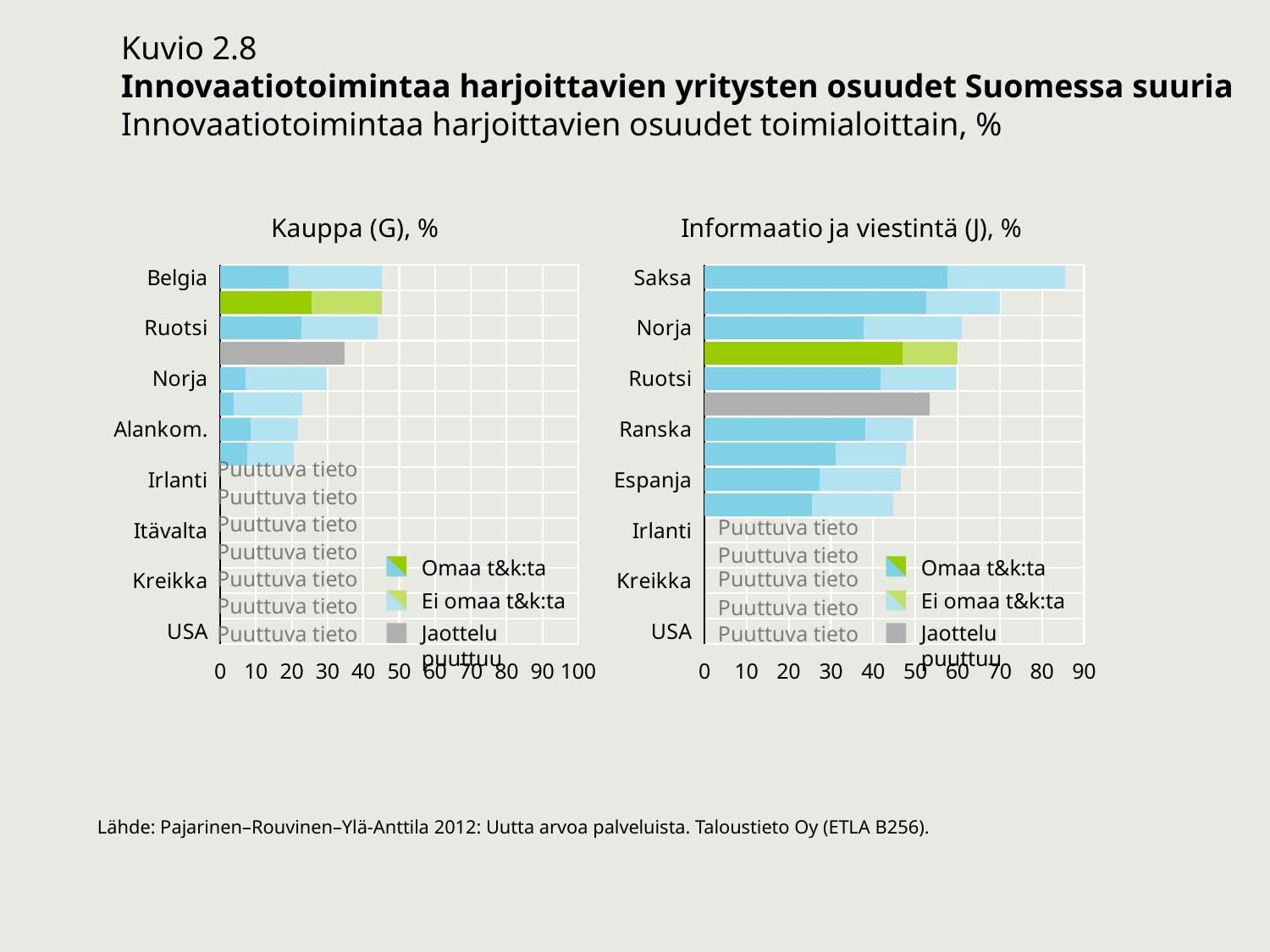
In the "Kauppa (G), %" chart, is the total value for Norja greater or less than 40? less In the "Informaatio ja viestintä (J), %" chart, is the total value for Norja greater or less than 50? greater In the "Informaatio ja viestintä (J), %" chart, is the total value for Saksa greater or less than 80? greater In the "Informaatio ja viestintä (J), %" chart, which labelled country has the highest total value? Saksa In the "Kauppa (G), %" chart, which has the larger total value, Belgia or Norja? Belgia What kind of chart is the "Kauppa (G), %" chart? bar chart How many series does the legend of the "Informaatio ja viestintä (J), %" chart list? 3 In the "Informaatio ja viestintä (J), %" chart, which has the larger total value, Saksa or Ranska? Saksa In the "Kauppa (G), %" chart, which labelled countries are marked "Puuttuva tieto" (missing data)? Irlanti, Itävalta, Kreikka, USA